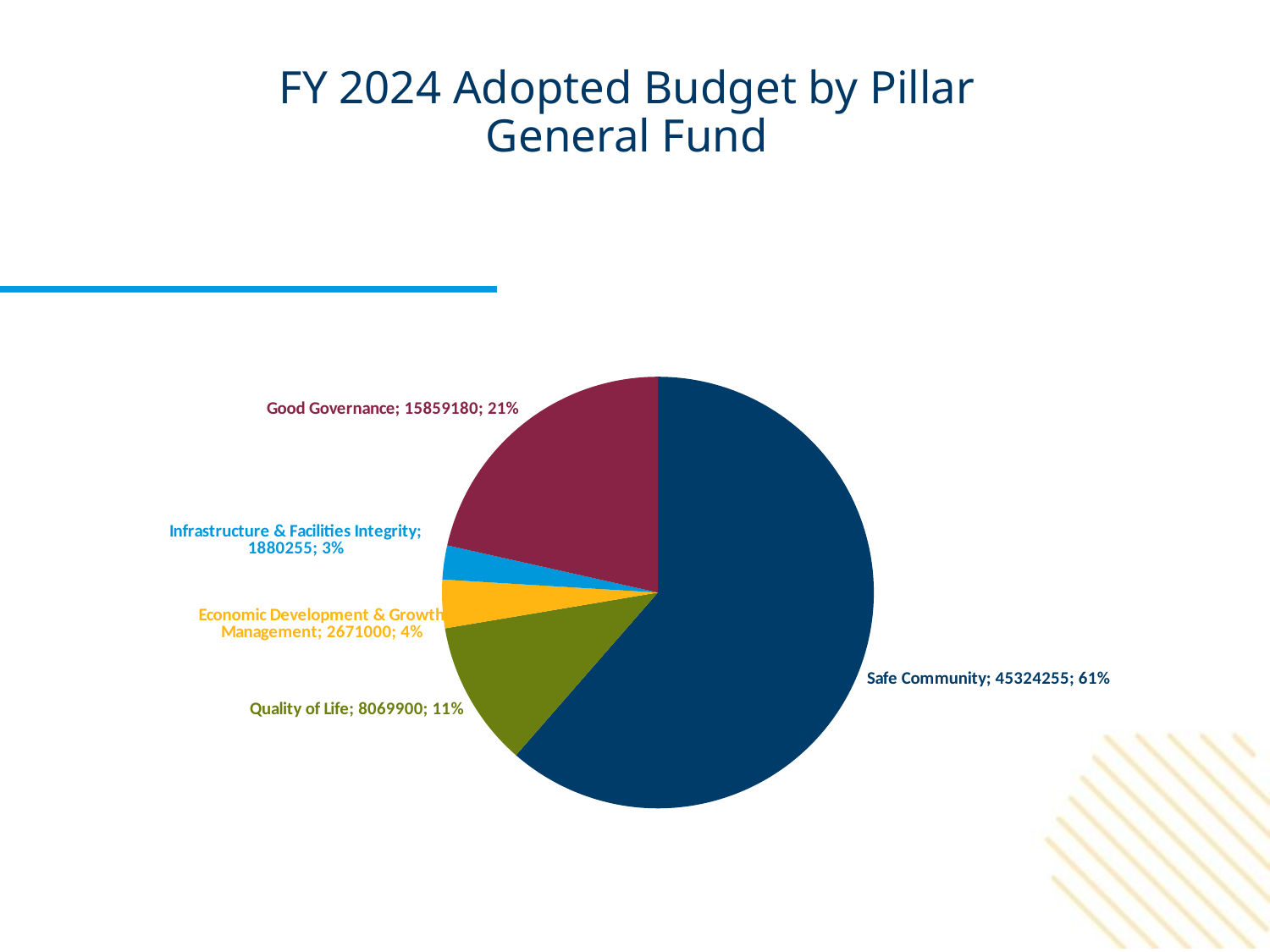
What kind of chart is shown on the slide? pie chart What share of the pie does Safe Community represent? 61% Which pillar has the largest slice? Safe Community What share of the pie does Economic Development & Growth Management represent? 4% What is the value for Good Governance? 15859180 What is the value for Safe Community? 45324255 How many slices does the pie chart have? 5 Which pillar has the smallest slice? Infrastructure & Facilities Integrity Which is larger, Good Governance or Quality of Life? Good Governance What is the value for Infrastructure & Facilities Integrity? 1880255 What is the value for Quality of Life? 8069900 What is the difference between the values for Good Governance and Quality of Life? 7789280